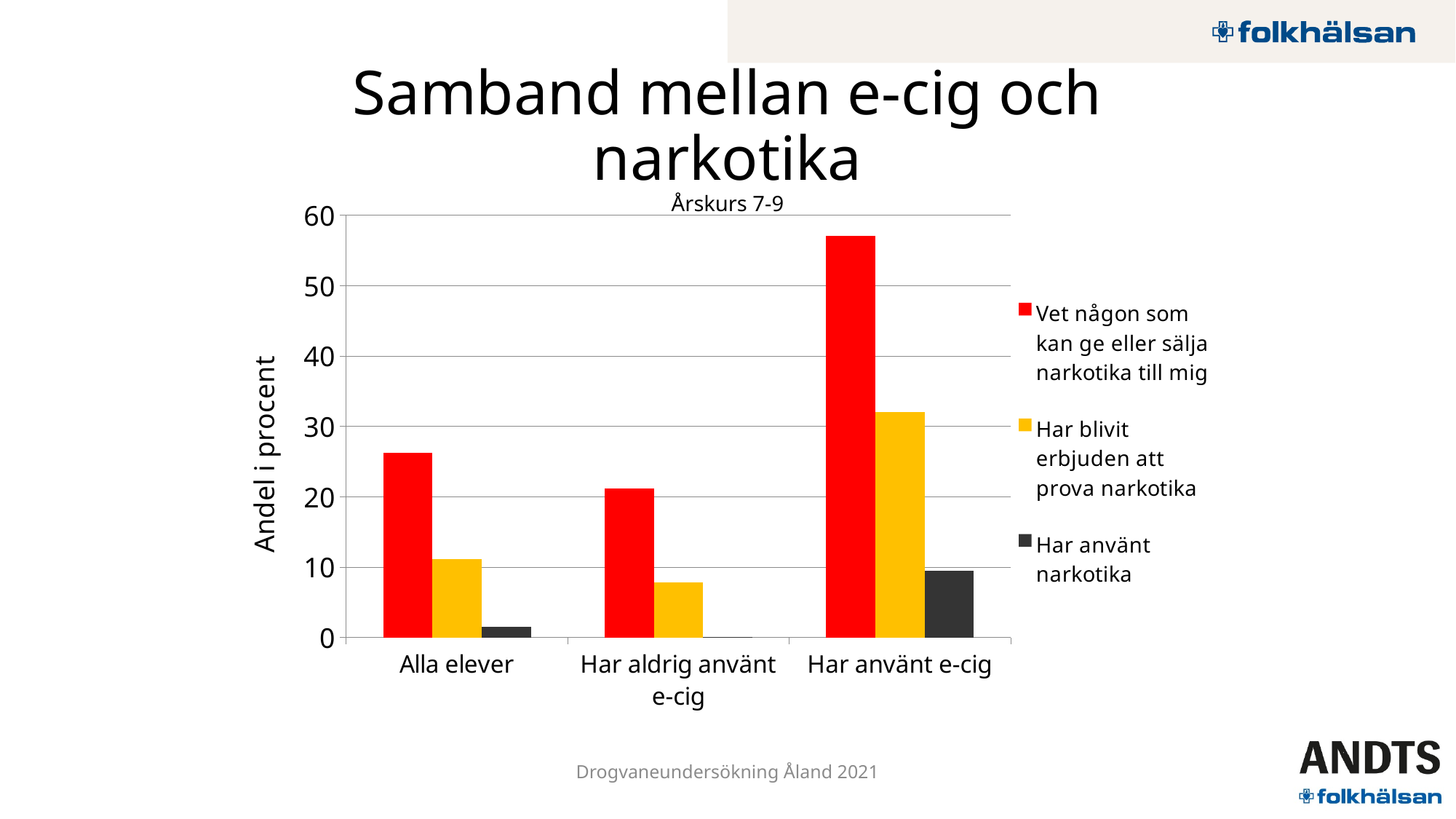
How many categories are shown on the x axis? 3 Is the value for 'Har blivit erbjuden att prova narkotika' in the 'Alla elever' category greater or less than 20? less Which category has the highest value for 'Vet någon som kan ge eller sälja narkotika till mig'? Har använt e-cig Is the value for 'Vet någon som kan ge eller sälja narkotika till mig' in the 'Har använt e-cig' category greater or less than 50? greater What is the label on the y axis of the chart? Andel i procent How many series does the legend list? 3 Which category has the highest value for 'Har använt narkotika'? Har använt e-cig What kind of chart is shown on the slide? bar chart Is the value for 'Har blivit erbjuden att prova narkotika' in the 'Har använt e-cig' category greater or less than 20? greater For 'Vet någon som kan ge eller sälja narkotika till mig', which is larger: 'Alla elever' or 'Har aldrig använt e-cig'? Alla elever Which category has the lowest value for 'Vet någon som kan ge eller sälja narkotika till mig'? Har aldrig använt e-cig